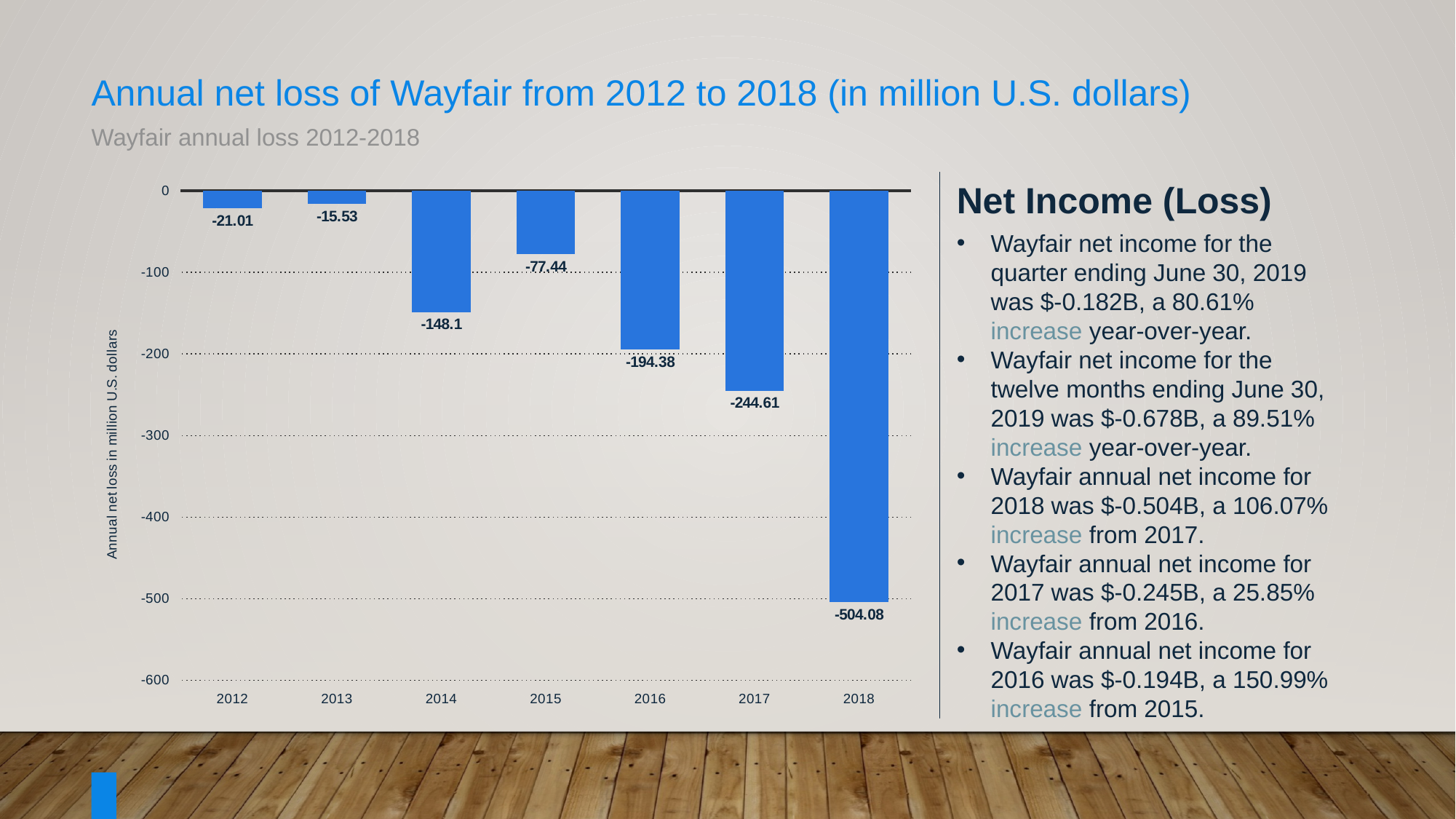
What is the difference between the 2016 value (-194.38) and the 2015 value (-77.44)? 116.94 What is the label on the vertical axis of the chart? Annual net loss in million U.S. dollars What value is labelled on the bar for 2014? -148.1 Which year has the smallest net loss (the value closest to zero)? 2013 Is the value for 2014 greater or less than -100? less By how much does the net loss in 2018 exceed the net loss in 2017, in million U.S. dollars? 259.47 What is the value shown for 2015? -77.44 What type of chart is used to show Wayfair's annual loss? Bar chart How many years (bars) are plotted in the chart? 7 What is the annual net loss value shown for 2018? -504.08 Which year has the largest net loss (the lowest value) in the chart? 2018 Which year shows a larger net loss, 2012 or 2013? 2012